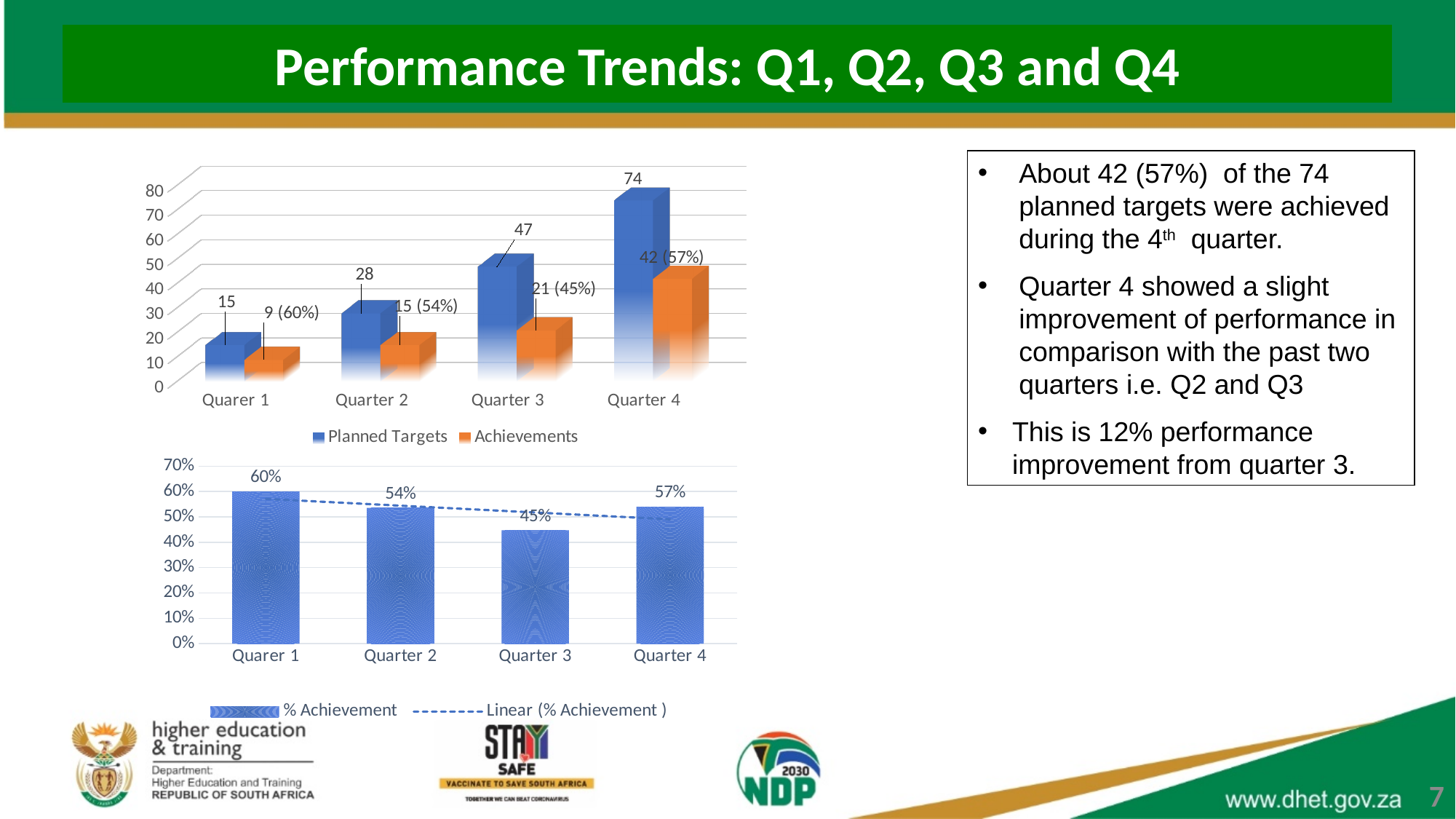
In the top chart, what is the difference between Planned Targets and Achievements for Quarter 4? 32 In the bottom chart, which is larger, the % Achievement for Quarter 2 or Quarter 4? Quarter 4 In the top chart, do the Planned Targets values rise or fall from Quarter 1 to Quarter 4? rise In the top chart, what is the Achievements data label for Quarter 3? 21 (45%) In the bottom chart, which quarter has the lowest % Achievement? Quarter 3 In the top chart, what is the Planned Targets value for Quarter 4? 74 What type of chart is the bottom chart? bar chart In the top chart, which quarter has the highest Planned Targets value? Quarter 4 In the top chart, how many series does the legend list? 2 In the top chart, what is the Planned Targets value for Quarter 2? 28 In the bottom chart, what is the difference between the % Achievement for Quarter 1 and Quarter 3? 15% In the bottom chart, what is the % Achievement for Quarter 3? 45%